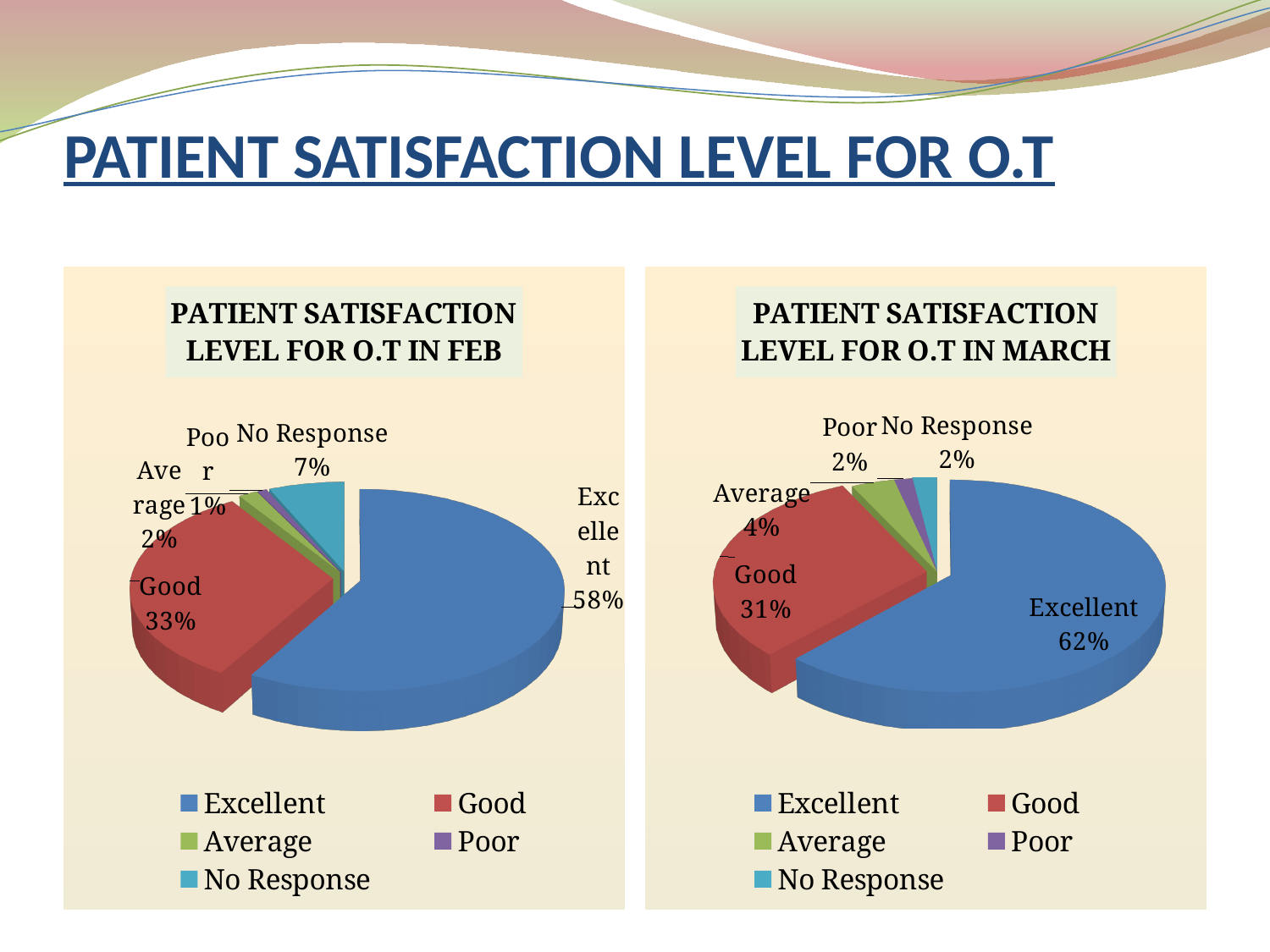
In the chart titled 'PATIENT SATISFACTION LEVEL FOR O.T IN MARCH', what is the difference in percentage points between Excellent and Good? 31 In the chart titled 'PATIENT SATISFACTION LEVEL FOR O.T IN MARCH', what percentage is labelled for Excellent? 62% In the chart titled 'PATIENT SATISFACTION LEVEL FOR O.T IN FEB', what percentage is labelled for No Response? 7% In the chart titled 'PATIENT SATISFACTION LEVEL FOR O.T IN MARCH', which category has the largest slice? Excellent In the chart titled 'PATIENT SATISFACTION LEVEL FOR O.T IN FEB', which category has the smallest slice? Poor How many categories does the legend of the chart titled 'PATIENT SATISFACTION LEVEL FOR O.T IN FEB' list? 5 In the chart titled 'PATIENT SATISFACTION LEVEL FOR O.T IN FEB', what colour represents the Good slice? Red In the chart titled 'PATIENT SATISFACTION LEVEL FOR O.T IN FEB', what percentage is labelled for Excellent? 58% Which is larger: the Excellent share in the FEB chart or the Excellent share in the MARCH chart? MARCH In the chart titled 'PATIENT SATISFACTION LEVEL FOR O.T IN MARCH', what percentage is labelled for Average? 4% In the chart titled 'PATIENT SATISFACTION LEVEL FOR O.T IN FEB', what percentage is labelled for Good? 33% What type of chart is the chart titled 'PATIENT SATISFACTION LEVEL FOR O.T IN MARCH'? Pie chart